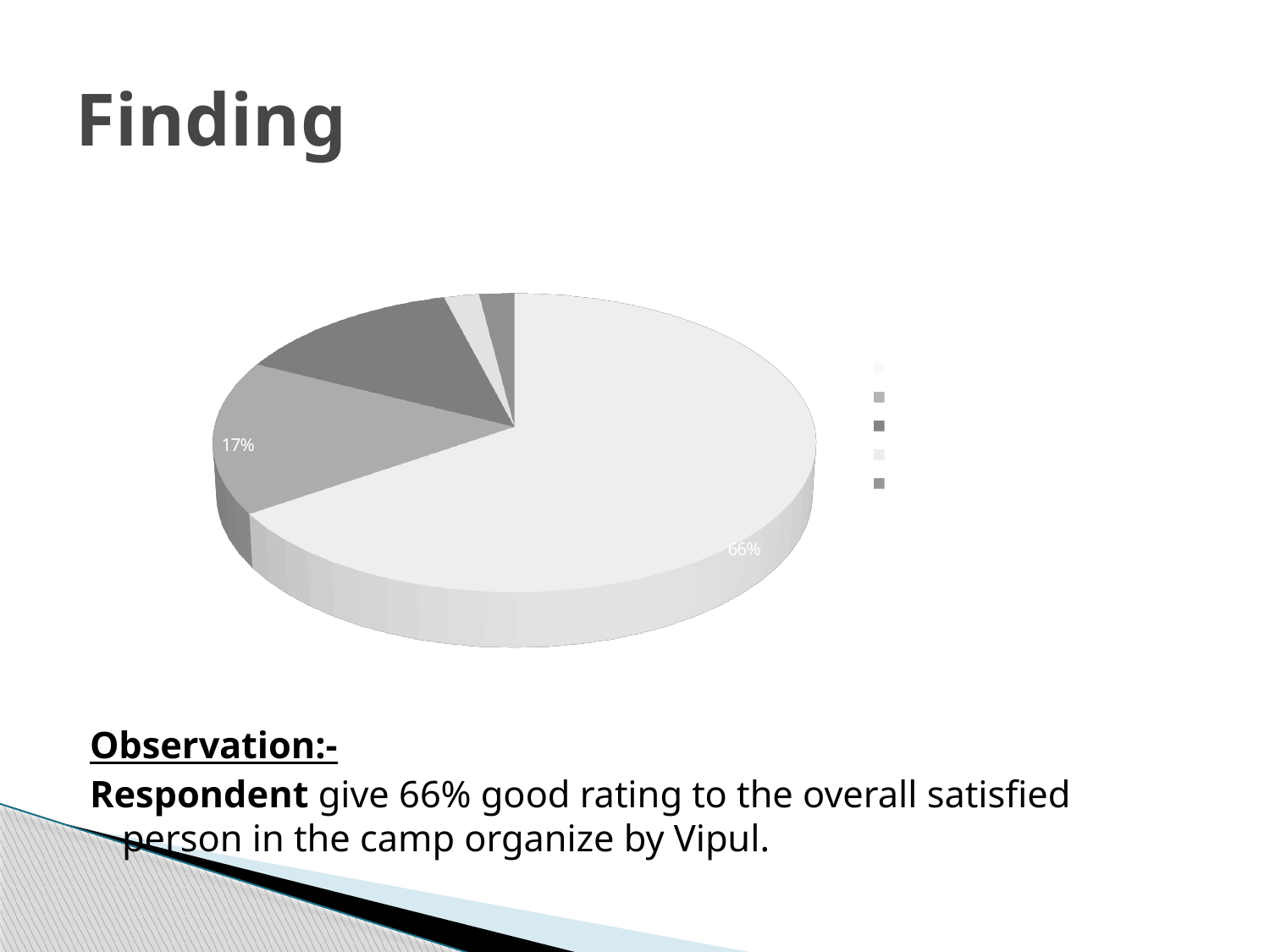
How many slices of the pie chart have a percentage label printed on them? 2 What is the share of the largest slice of the pie chart? 66% Is the share of the largest slice of the pie chart greater or less than 50%? greater Does the pie chart have a title printed above it? No What percentage is printed on the largest slice of the pie chart? 66% What percentage is printed on the slice on the left side of the pie chart? 17% How many entries does the legend of the pie chart list? 5 What is the share of the second-largest slice of the pie chart? 17% Which is larger: the slice labelled 66% or the slice labelled 17%? the slice labelled 66% What kind of chart is shown on the slide? pie chart How many slices does the pie chart have? 5 By how many percentage points does the largest slice exceed the slice labelled 17%? 49